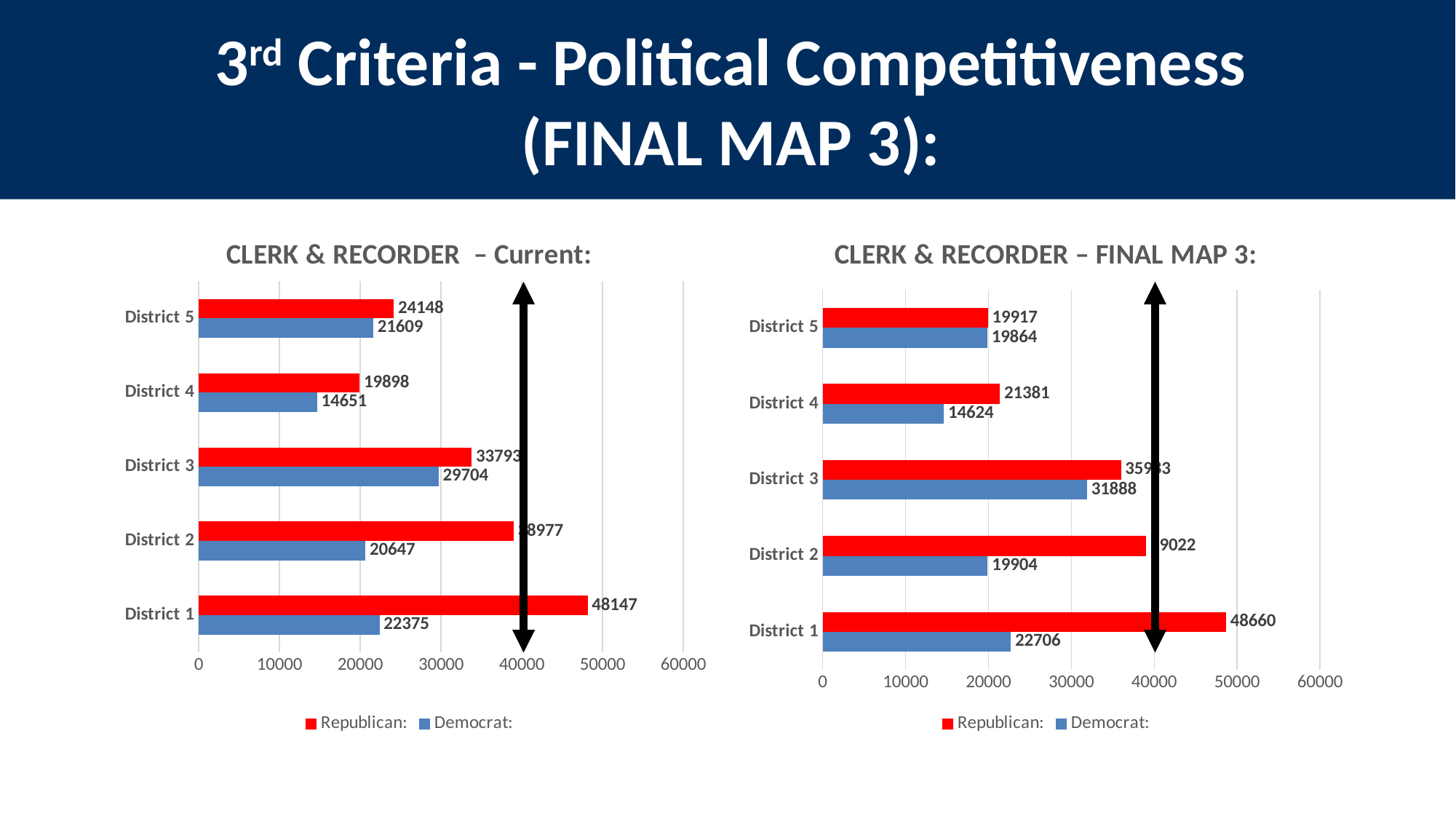
In the CLERK & RECORDER – Current chart, which district has the highest Republican value? District 1 In the CLERK & RECORDER – Current chart, what is the Democrat value for District 4? 14651 In the CLERK & RECORDER – Current chart, what is the Republican value for District 1? 48147 In the CLERK & RECORDER – FINAL MAP 3 chart, what is the Republican value for District 5? 19917 In the CLERK & RECORDER – FINAL MAP 3 chart, which district has the lowest Democrat value? District 4 In the CLERK & RECORDER – Current chart, what is the difference between the Republican and Democrat values for District 5? 2539 In the CLERK & RECORDER – FINAL MAP 3 chart, is the Republican value for District 2 greater or less than 30000? greater How many districts are shown in the CLERK & RECORDER – Current chart? 5 In the CLERK & RECORDER – FINAL MAP 3 chart, what is the Democrat value for District 3? 31888 In the CLERK & RECORDER – FINAL MAP 3 chart, what is the difference between the Republican and Democrat values for District 1? 25954 How many series does the legend of the CLERK & RECORDER – FINAL MAP 3 chart list? 2 In the CLERK & RECORDER – Current chart, is the Democrat value for District 3 larger or smaller than the Democrat value for District 2? larger